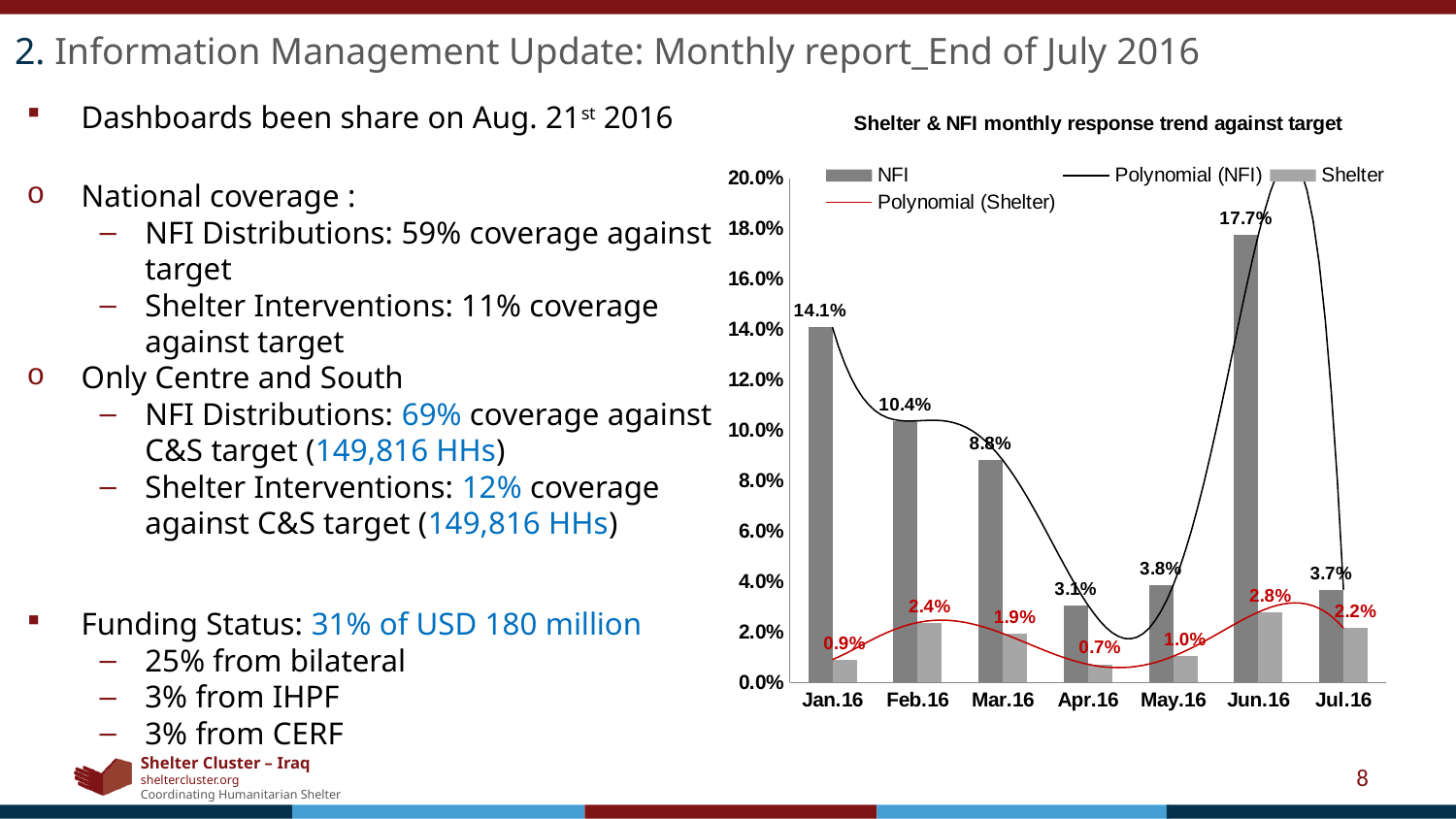
What kind of chart is used to show the NFI and Shelter values? Bar chart Which month has the lowest Shelter value? Apr.16 How many entries does the legend list? 4 Which is larger, the NFI value for Feb.16 or the NFI value for Mar.16? Feb.16 Is the NFI value for Jan.16 greater or less than 12.0%? greater What is the NFI value for Apr.16? 3.1% What is the difference between the NFI value and the Shelter value in Jan.16? 13.2% How many months are shown on the x axis? 7 Which month has the highest NFI value? Jun.16 What is the title of the chart? Shelter & NFI monthly response trend against target What is the NFI value for Jun.16? 17.7% What is the Shelter value for Feb.16? 2.4%